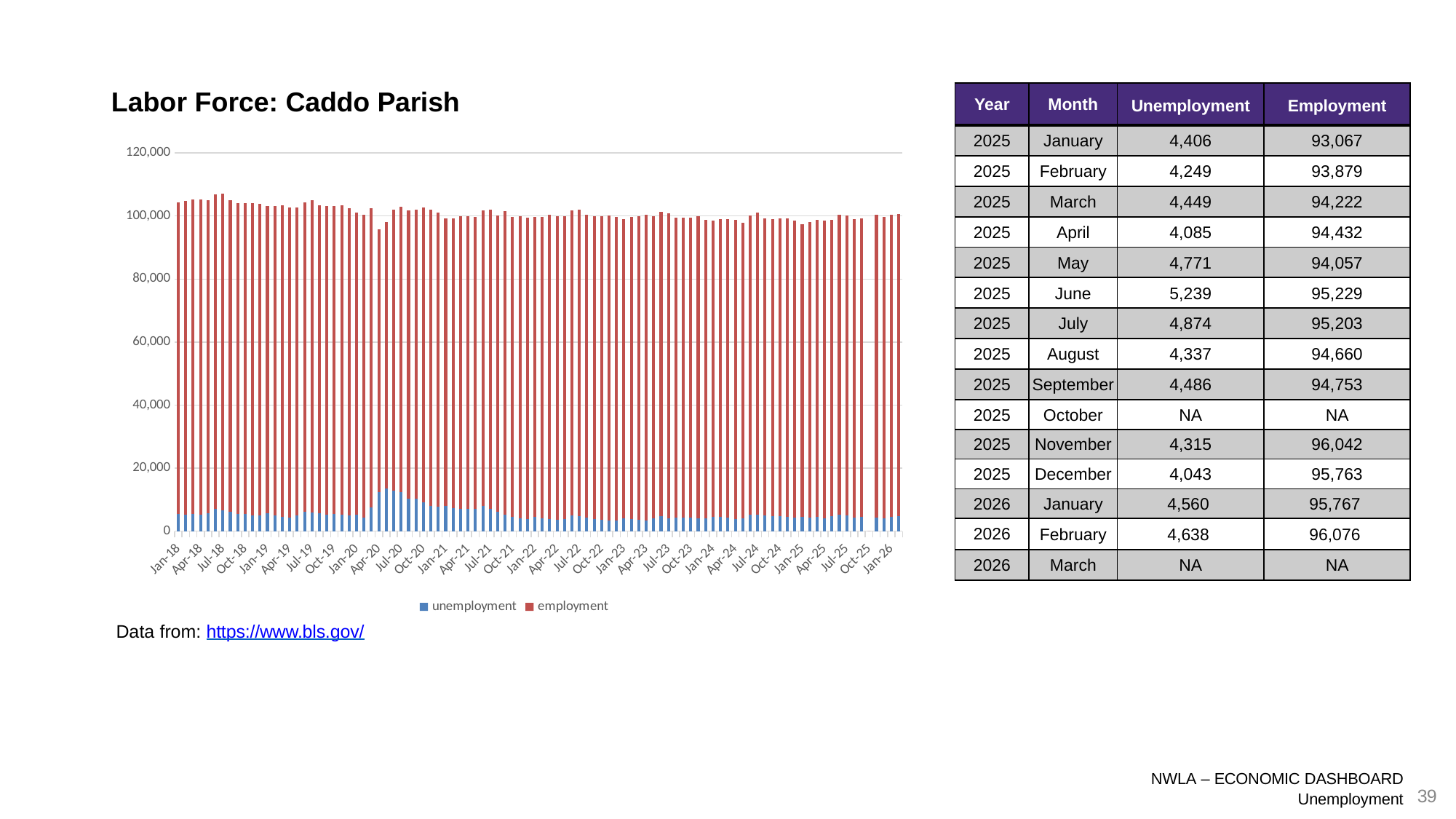
According to the table on the slide, what was employment in Caddo Parish in February 2026? 96,076 According to the table on the slide, what was unemployment in Caddo Parish in June 2025? 5,239 Which series is shown in red on the chart? employment Using the table on the slide, how much higher was employment in February 2026 than in January 2026? 309 Is the unemployment value for Jul-20 greater or less than 20,000? less What kind of chart is shown on the slide? bar chart What is the title of the slide's chart? Labor Force: Caddo Parish Which series has the larger values throughout the chart, unemployment or employment? employment Among the months listed in the table, which month of 2025 had the highest unemployment? June How many series does the chart's legend list? 2 Is the employment value for Apr-20 greater or less than 100,000? less